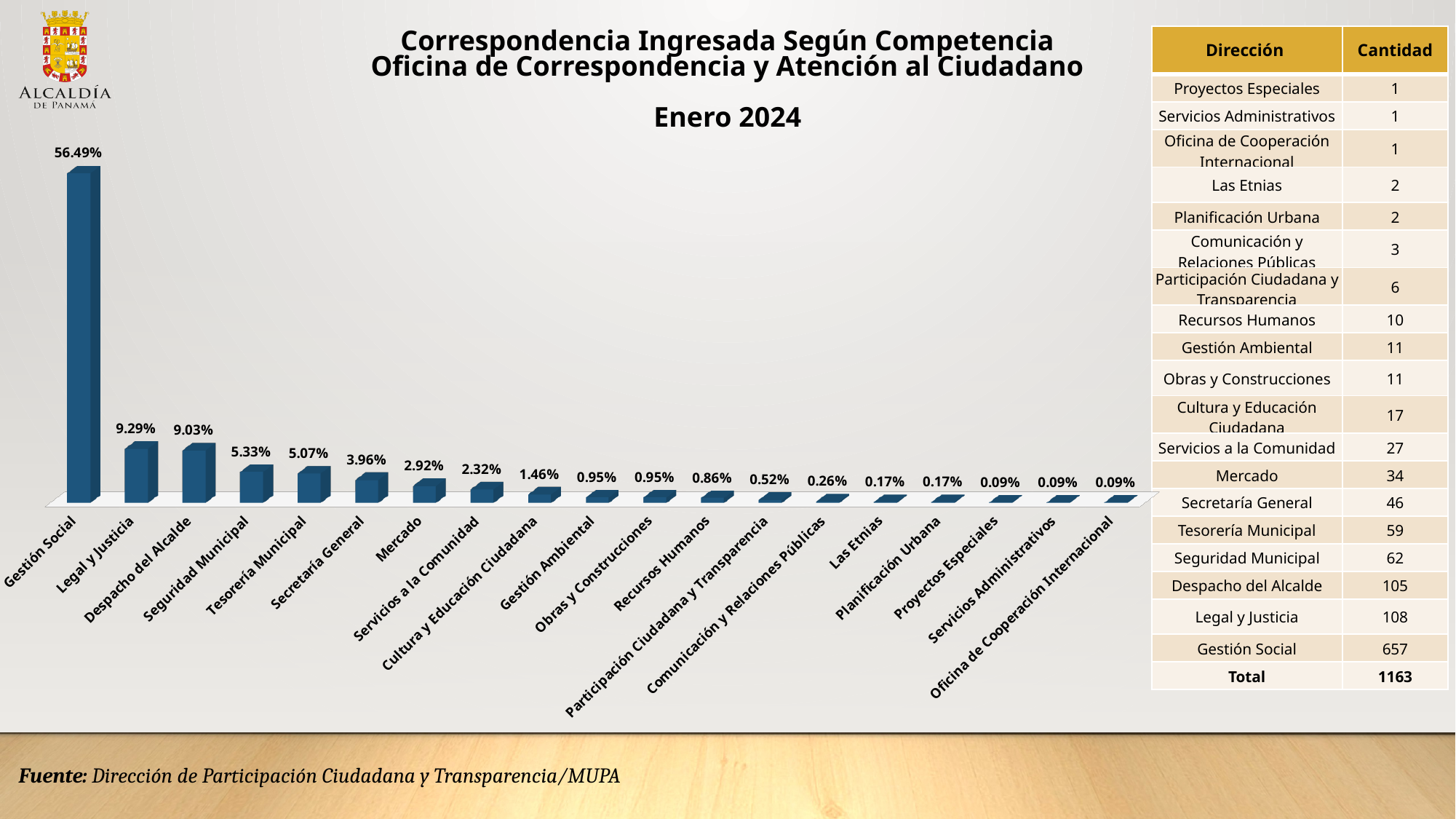
Do the values rise or fall from left to right along the x axis? Fall What is the value for Gestión Social? 56.49% What is the value for Tesorería Municipal? 5.07% How many categories are shown on the x axis? 19 What is the value for Legal y Justicia? 9.29% What kind of chart is shown on the slide? Bar chart What is the difference between Legal y Justicia and Despacho del Alcalde? 0.26% What is the value for Recursos Humanos? 0.86% Which category has the highest value? Gestión Social Which is larger, Seguridad Municipal or Tesorería Municipal? Seguridad Municipal What is the value for Comunicación y Relaciones Públicas? 0.26% What is the difference between Secretaría General and Mercado? 1.04%